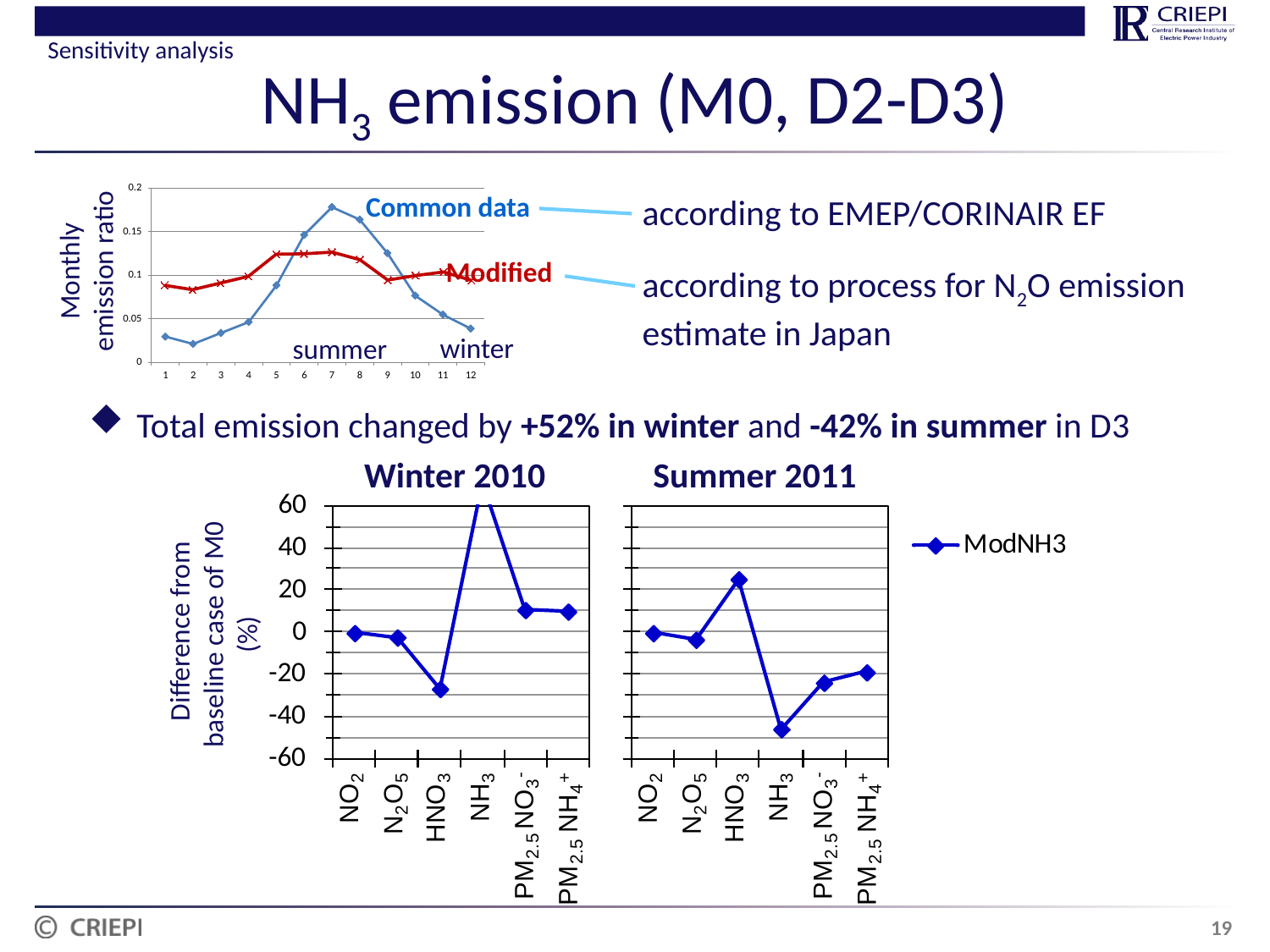
In the Winter 2010 chart, is the value for NH3 greater or less than 40? greater How many categories are plotted on the x axis of the Summer 2011 chart? 6 In the Summer 2011 chart, which category has the lowest value? NH3 In the Summer 2011 chart, which is larger, the value for HNO3 or the value for PM2.5 NO3-? HNO3 In the Summer 2011 chart, is the value for NH3 greater or less than -40? less In the monthly emission ratio chart at the top left, is the Common data value for month 7 greater or less than 0.15? greater In the Winter 2010 chart, which category has the highest value? NH3 In the Summer 2011 chart, which category has the highest value? HNO3 What kind of chart is the Winter 2010 chart? line chart In the Winter 2010 chart, which category has the lowest value? HNO3 What series name does the legend next to the Winter 2010 and Summer 2011 charts list? ModNH3